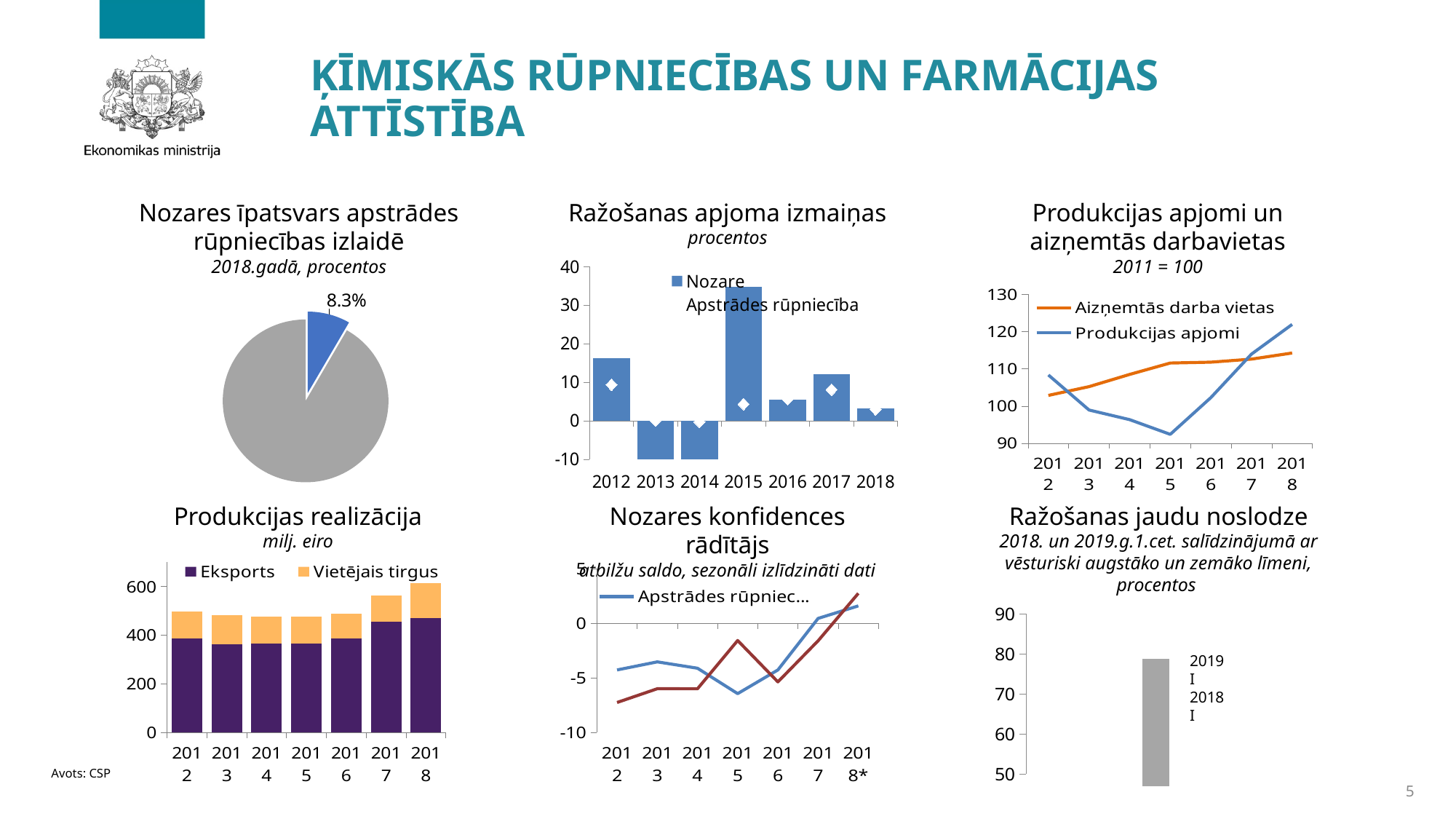
What kind of chart is 'Nozares īpatsvars apstrādes rūpniecības izlaidē'? pie chart In the chart 'Ražošanas apjoma izmaiņas', which bar is taller, 2012 or 2017? 2012 How many series does the legend list in the chart 'Produkcijas apjomi un aizņemtās darbavietas'? 2 In the chart 'Produkcijas realizācija', is the 'Eksports' value for 2018 greater or less than 400? greater In the chart 'Ražošanas apjoma izmaiņas', is the bar for 2015 greater or less than 30? greater In the pie chart 'Nozares īpatsvars apstrādes rūpniecības izlaidē', what share is shown for the blue slice? 8.3% In the chart 'Produkcijas apjomi un aizņemtās darbavietas', is the value of 'Produkcijas apjomi' in 2018 greater or less than 120? greater What are the two legend entries in the chart 'Produkcijas realizācija'? Eksports, Vietējais tirgus In the chart 'Produkcijas apjomi un aizņemtās darbavietas', does the 'Aizņemtās darba vietas' line rise or fall from 2012 to 2018? rise In the chart 'Produkcijas realizācija', which year has the tallest stacked bar? 2018 In the chart 'Ražošanas apjoma izmaiņas', which year has the highest bar? 2015 In the chart 'Ražošanas apjoma izmaiņas', how many years are shown on the x axis? 7